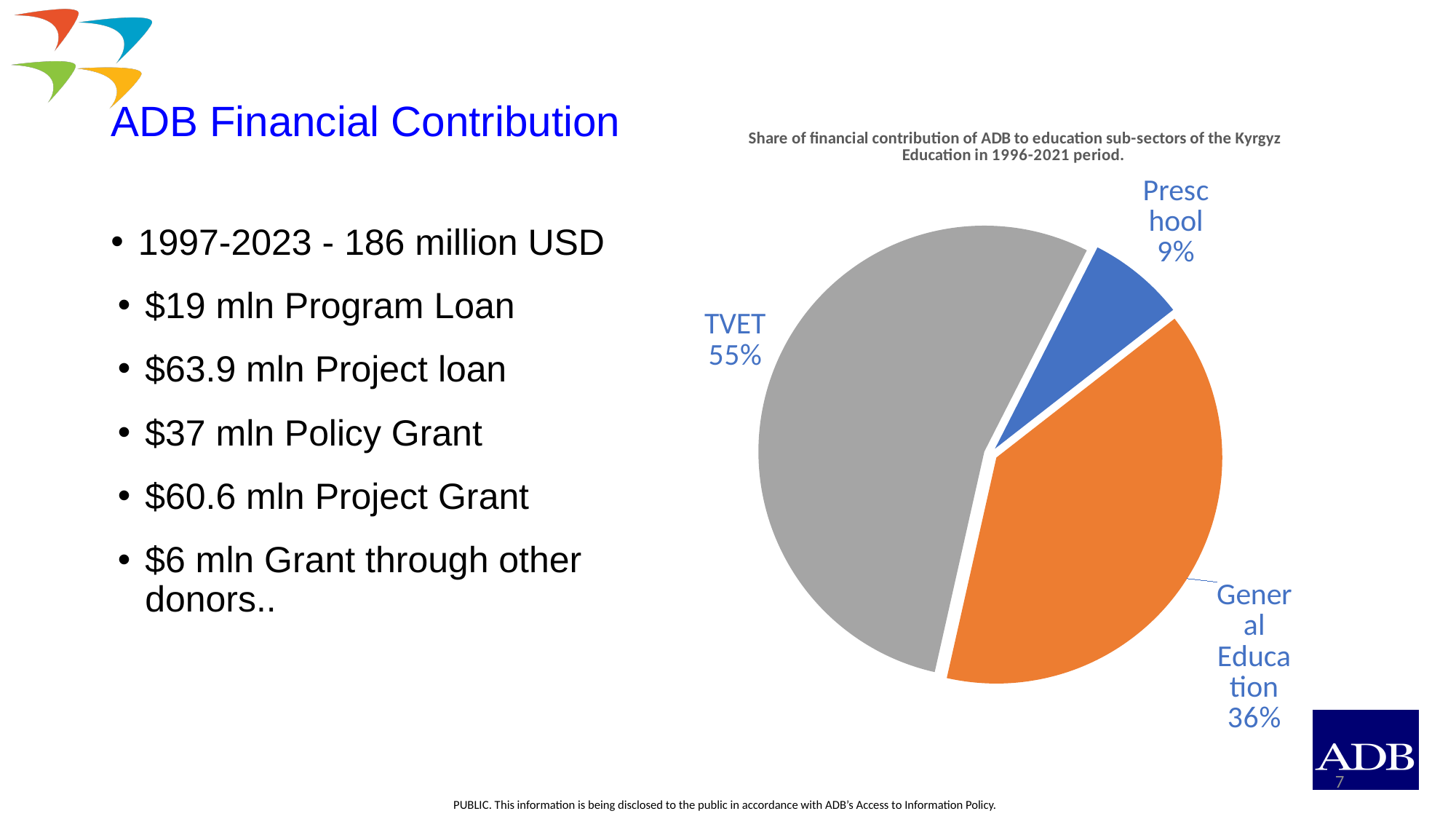
Which is larger, the share for General Education or the share for Preschool? General Education What is the title of the pie chart? Share of financial contribution of ADB to education sub-sectors of the Kyrgyz Education in 1996-2021 period. What type of chart is shown on the slide? pie chart What share of ADB's financial contribution went to General Education? 36% Which education sub-sector received the smallest share of ADB's contribution? Preschool What share of ADB's financial contribution went to TVET? 55% What share of ADB's financial contribution went to Preschool? 9% Which education sub-sector received the largest share of ADB's contribution? TVET What colour is the TVET slice of the pie chart? grey How many percentage points larger is the TVET share than the General Education share? 19 How many percentage points larger is the General Education share than the Preschool share? 27 How many slices does the pie chart have? 3